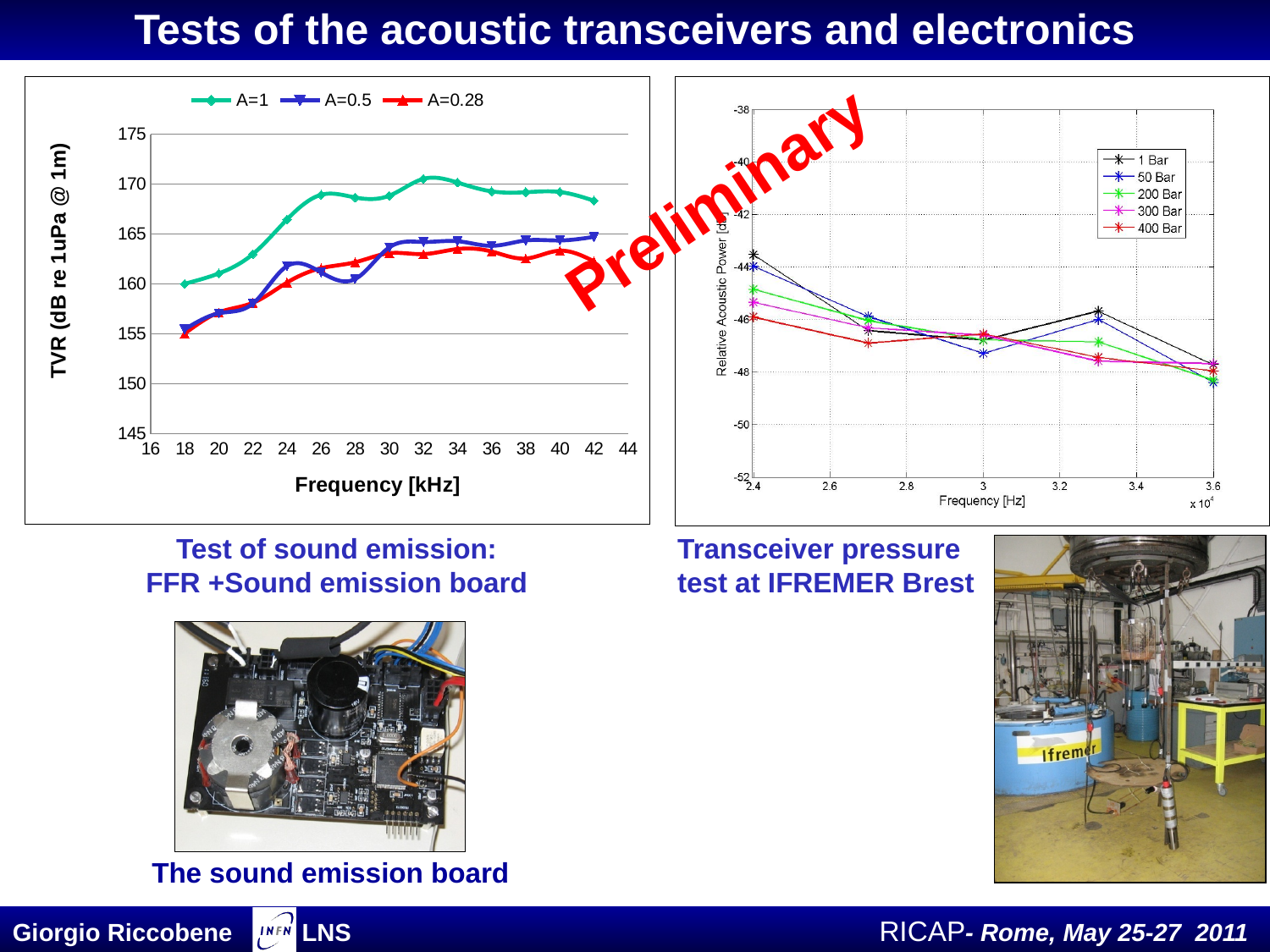
In the right chart (Relative Acoustic Power vs Frequency), which is larger at 3.3 x 10^4 Hz: 1 Bar or 50 Bar? 1 Bar In the left chart (TVR vs Frequency), is the value of A=0.28 at 18 kHz greater or less than 160? less In the left chart (TVR vs Frequency), which series has the highest value at 32 kHz? A=1 What kind of chart is the left chart (TVR vs Frequency)? line chart In the right chart (Relative Acoustic Power vs Frequency), which series has the highest value at the leftmost frequency point (2.4 x 10^4 Hz)? 1 Bar In the left chart (TVR vs Frequency), does the A=1 series rise or fall from 18 kHz to 32 kHz? rise In the left chart (TVR vs Frequency), is the value of A=1 at 32 kHz greater or less than 165? greater In the right chart (Relative Acoustic Power vs Frequency), is the value of 400 Bar at 2.4 x 10^4 Hz greater or less than -44? less How many series does the legend of the left chart (TVR vs Frequency) list? 3 What is the x-axis label of the left chart (TVR vs Frequency)? Frequency [kHz] How many series does the legend of the right chart (Relative Acoustic Power vs Frequency) list? 5 What are the legend entries of the left chart (TVR vs Frequency)? A=1, A=0.5, A=0.28